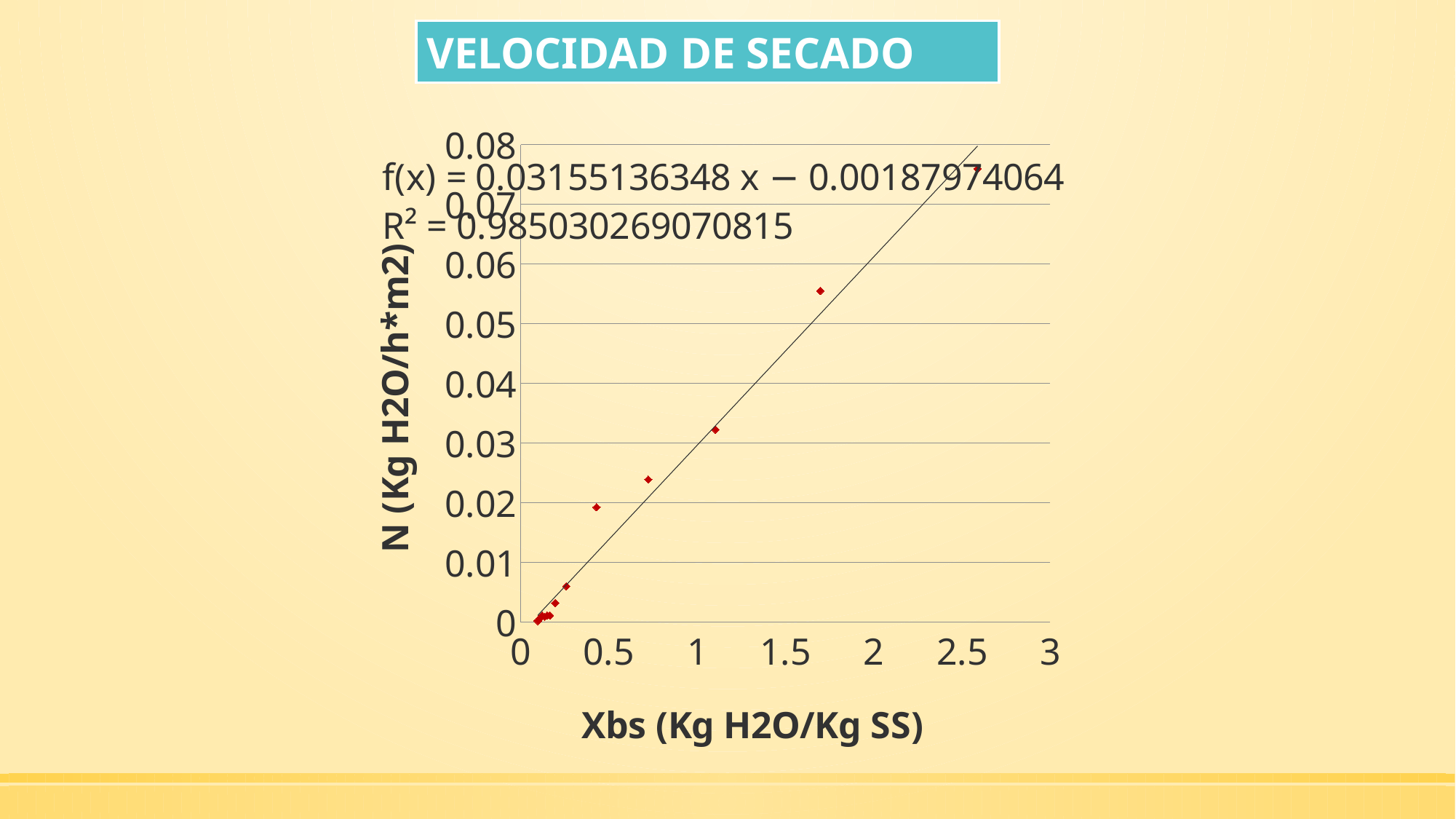
As Xbs increases along the x axis, do the N values rise or fall? Rise What is the highest value shown on the x axis? 3 Which data point has a larger N value: the one near Xbs = 1.1 or the one near Xbs = 1.7? The one near Xbs = 1.7 Is the N value of the data point plotted near Xbs = 1.1 greater or less than 0.04? less Is the N value of the data point plotted near Xbs = 0.7 greater or less than 0.03? less What is the trendline equation shown on the chart? f(x) = 0.03155136348 x − 0.00187974064 Is the N value of the data point plotted near Xbs = 1.7 greater or less than 0.05? greater What kind of chart is shown on the slide? Scatter chart What is the R² value shown for the trendline? 0.985030269070815 What is the highest value shown on the y axis? 0.08